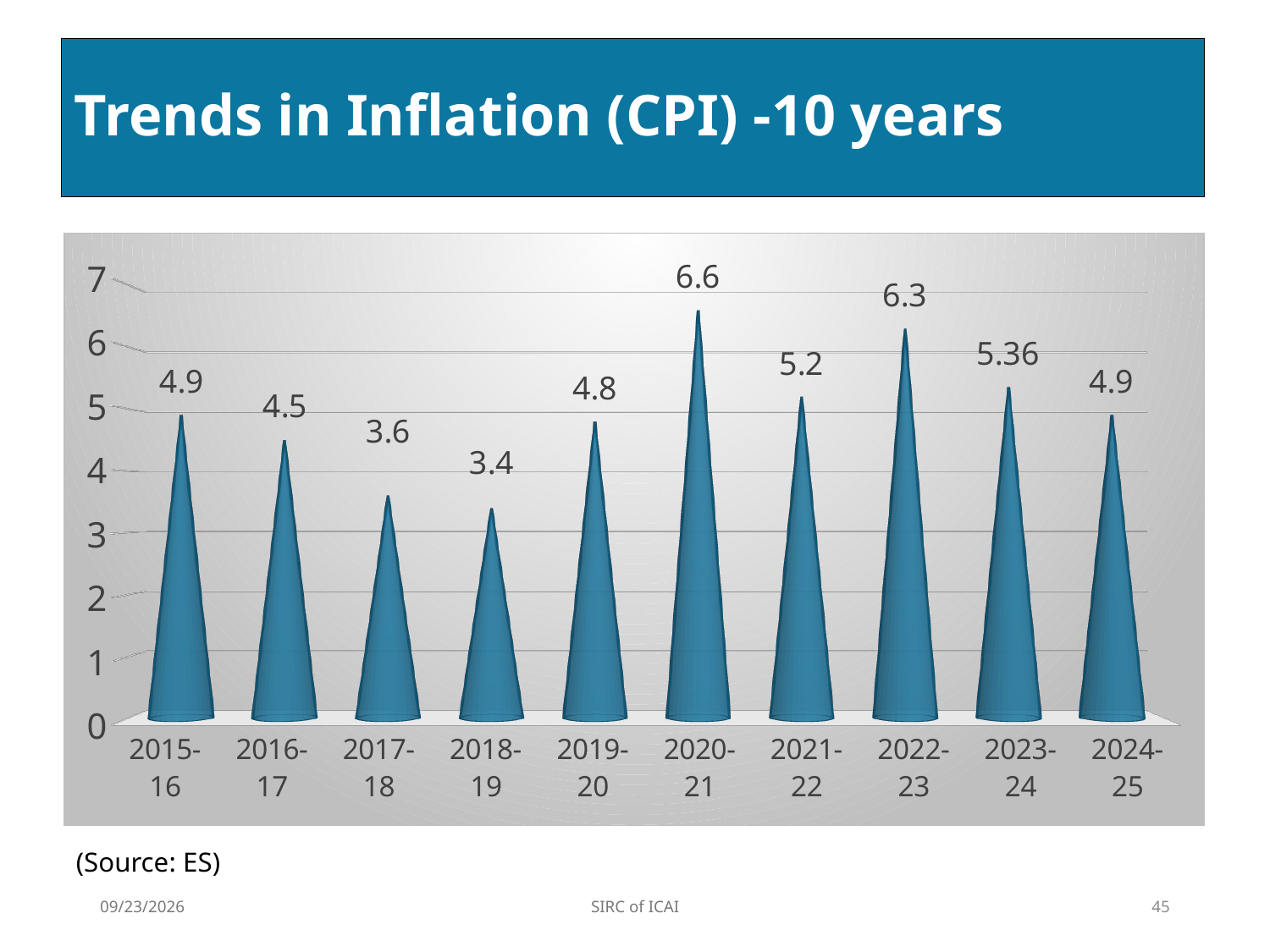
Which is larger, the CPI inflation value for 2021-22 or for 2022-23? 2022-23 Which year has the lowest CPI inflation value? 2018-19 What is the difference between the CPI inflation values for 2020-21 and 2018-19? 3.2 Which year has the highest CPI inflation value? 2020-21 How many years are shown on the chart? 10 What is the CPI inflation value for 2023-24? 5.36 Does the CPI inflation value rise or fall from 2018-19 to 2020-21? rise What is the CPI inflation value for 2018-19? 3.4 What is the CPI inflation value for 2020-21? 6.6 What is the title of the chart on the slide? Trends in Inflation (CPI) -10 years What kind of chart is shown on the slide? bar chart Is the CPI inflation value for 2017-18 greater or less than 4? less